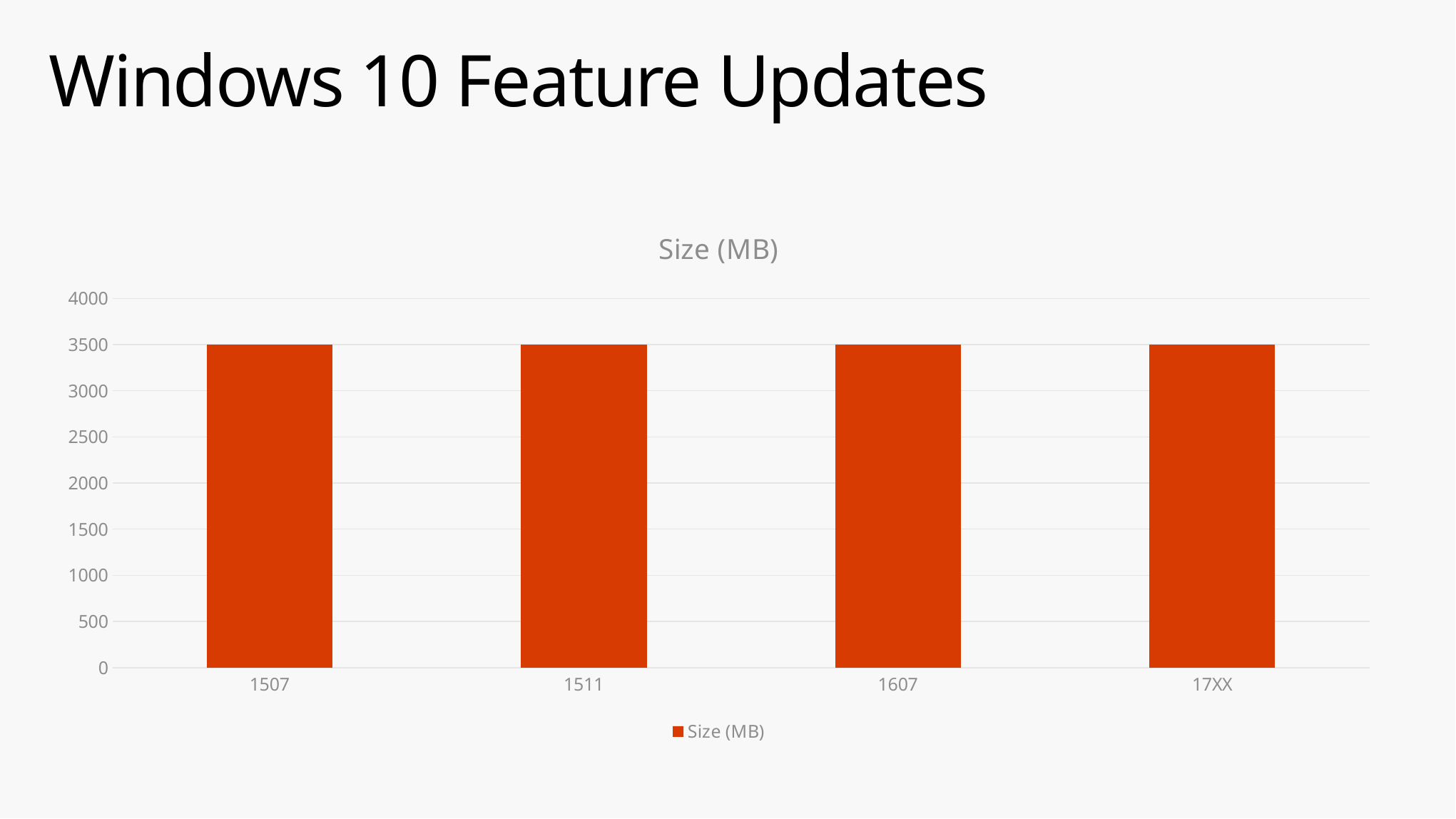
What is the value for 17XX? 3500 What is the difference between the values for 1507 and 1511? 0 How many series does the legend list? 1 What is the value for 1507? 3500 What is the value for 1607? 3500 Is the value for 17XX greater or less than 4000? less How many categories are shown on the x axis of the chart? 4 What is the value for 1511? 3500 What is the title of the chart? Size (MB) What kind of chart is shown on the slide? bar chart Is the value for 1607 greater or less than 3000? greater Do the values rise, fall, or stay the same from 1507 to 17XX? stay the same